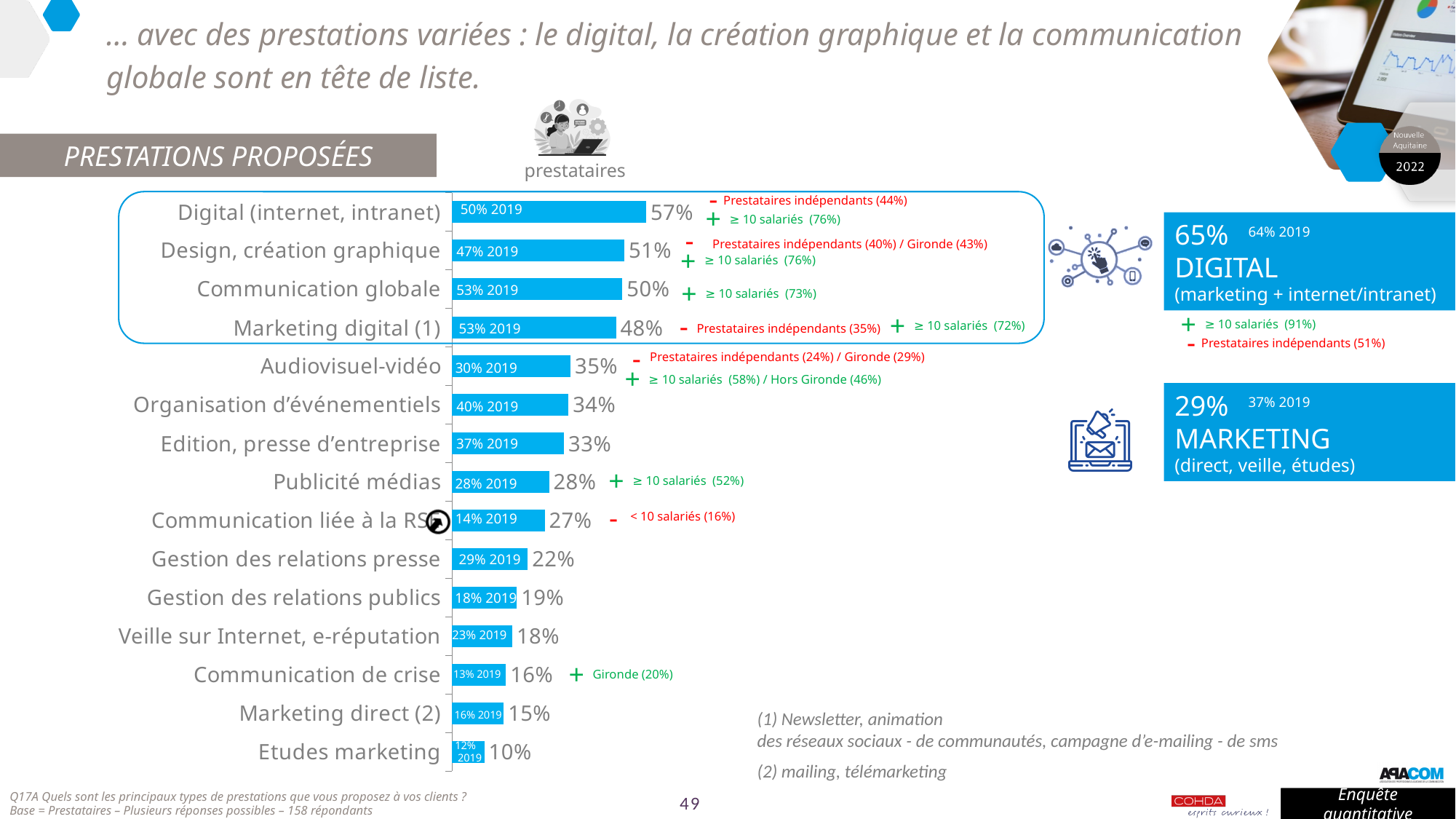
What is the 2022 value for 'Audiovisuel-vidéo'? 35% Which is larger: the value for 'Design, création graphique' or the value for 'Communication globale'? Design, création graphique What is the value for 'Communication de crise'? 16% Which prestation has the lowest percentage in the bar chart? Etudes marketing What is the value for 'Gestion des relations presse'? 22% What is the 2019 value shown for 'Marketing digital (1)'? 53% What kind of chart is used to show the 'Prestations proposées' data? bar chart What is the difference between the 2022 value for 'Digital (internet, intranet)' (57%) and its 2019 value (50%)? 7 points What is the difference between 'Communication liée à la RSE' in 2022 (27%) and in 2019 (14%)? 13 points How many prestation categories are plotted in the bar chart? 15 What was the 2019 value for 'Communication liée à la RSE'? 14% Which prestation has the highest percentage in the bar chart? Digital (internet, intranet)